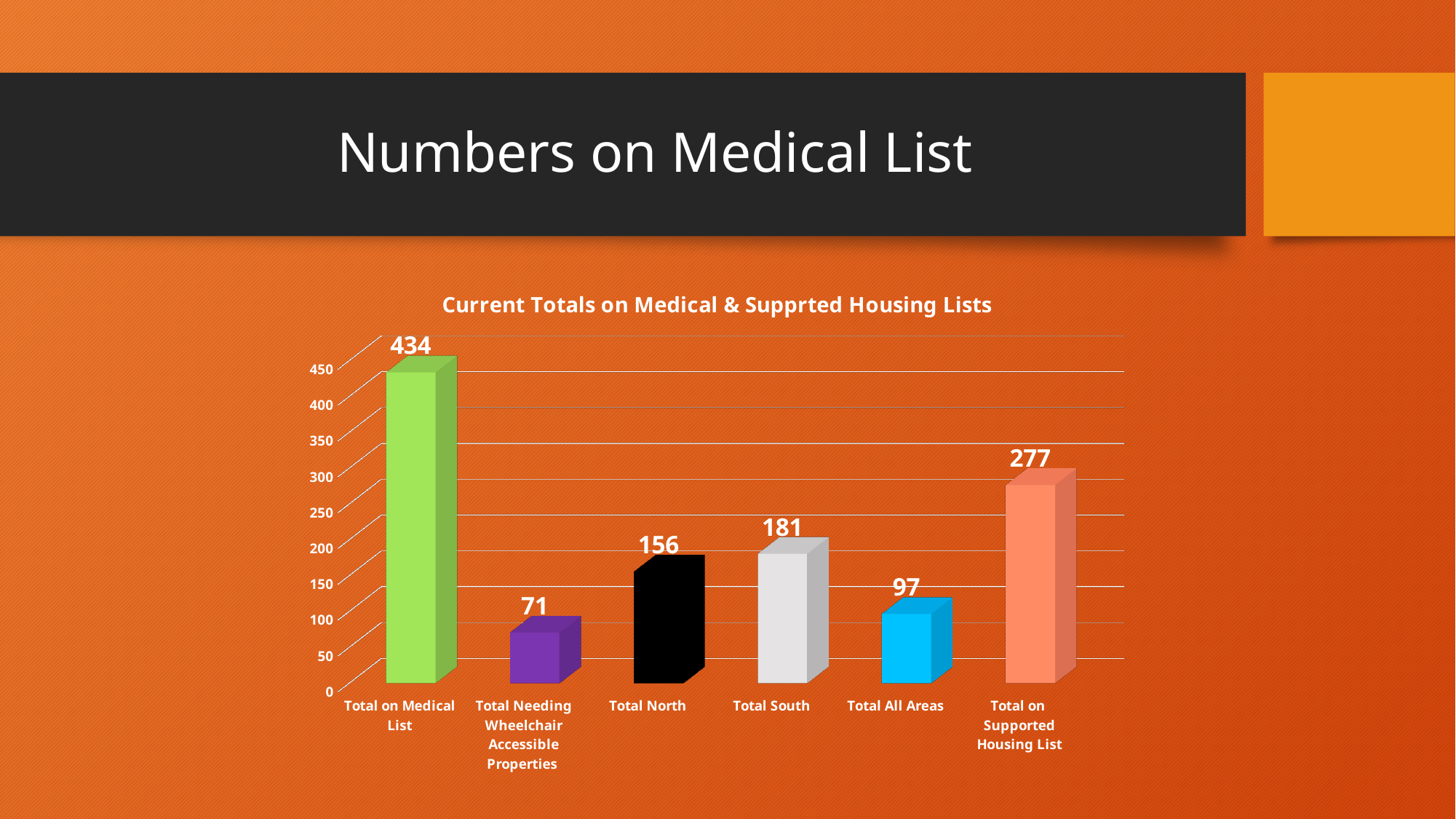
Which category has the lowest value? Total Needing Wheelchair Accessible Properties Is the value for Total on Supported Housing List greater or less than 250? greater What is the title of the chart? Current Totals on Medical & Supprted Housing Lists What is the value for Total on Medical List? 434 What is the value for Total on Supported Housing List? 277 How many categories are shown in the chart? 6 What is the difference between Total South and Total North? 25 Which category has the highest value? Total on Medical List Which is larger, Total All Areas or Total South? Total South What kind of chart is shown on the slide? Bar chart What is the value for Total Needing Wheelchair Accessible Properties? 71 What is the value for Total North? 156